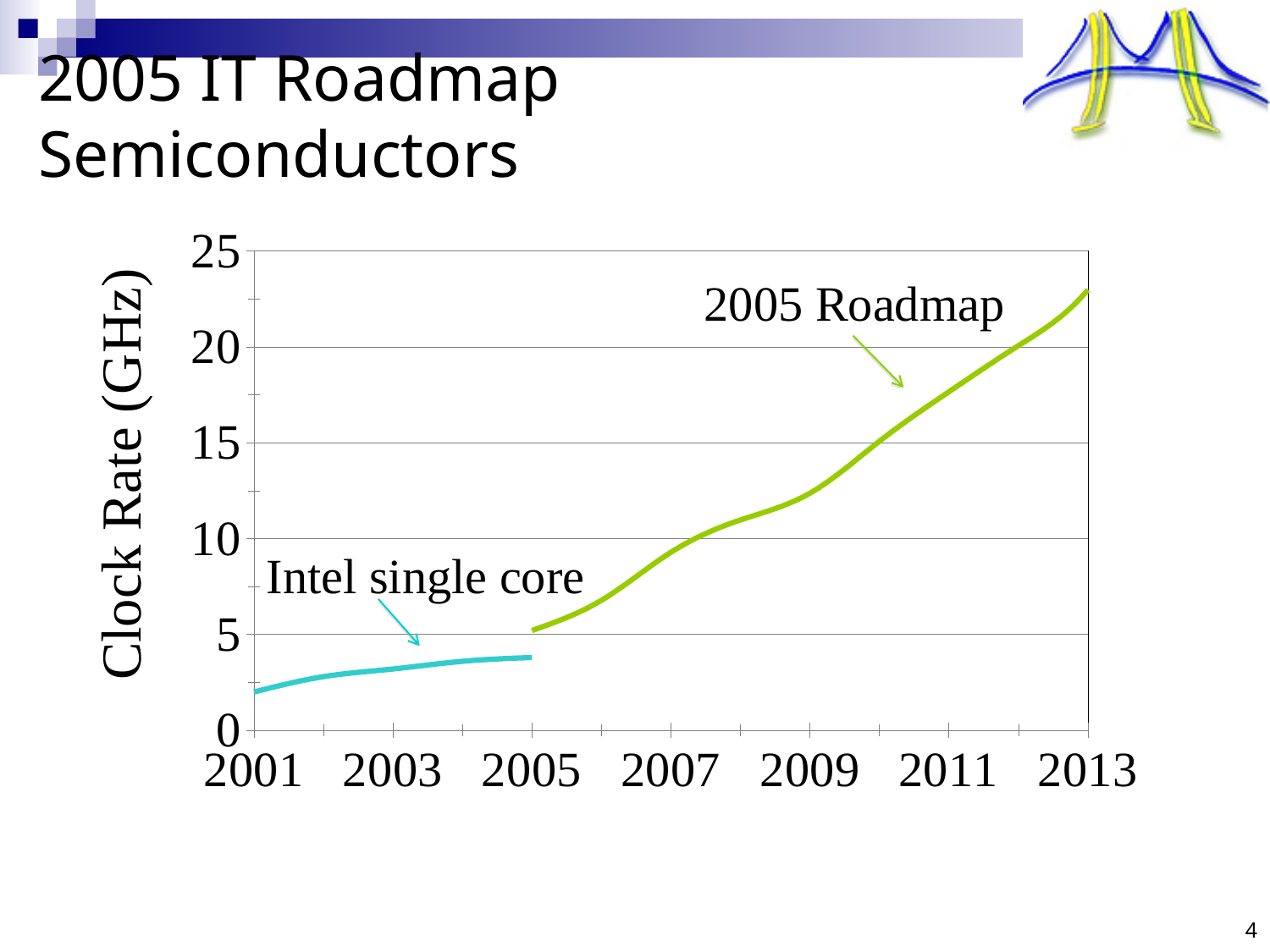
What are the two labelled lines on the chart? Intel single core and 2005 Roadmap Is the value of the Intel single core line in 2005 greater or less than 5? less Does the Intel single core line rise or fall from 2001 to 2005? rise Which is larger: the 2005 Roadmap value in 2013 or the Intel single core value in 2005? 2005 Roadmap value in 2013 Is the value of the 2005 Roadmap line in 2011 greater or less than 15? greater What kind of chart is shown on the slide? line chart Does the 2005 Roadmap line rise or fall from 2005 to 2013? rise Is the value of the 2005 Roadmap line in 2009 greater or less than 10? greater What is the title of the vertical axis? Clock Rate (GHz) How many lines are plotted on the chart? 2